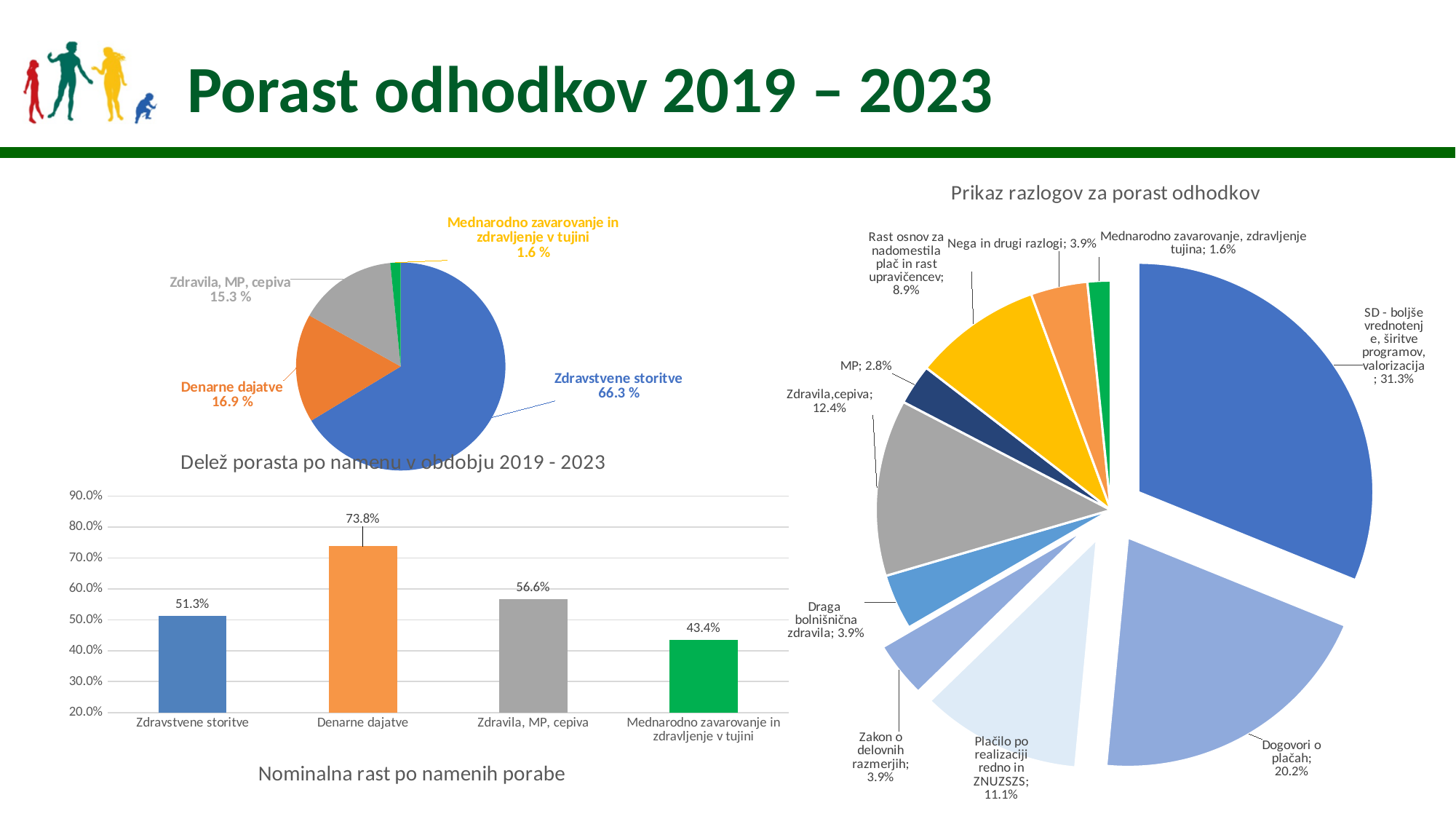
In the 'Nominalna rast po namenih porabe' bar chart, what is the value for Denarne dajatve? 73.8% In the 'Nominalna rast po namenih porabe' bar chart, which category has the lowest value? Mednarodno zavarovanje in zdravljenje v tujini In the 'Prikaz razlogov za porast odhodkov' pie chart, what is the value for 'Zdravila,cepiva'? 12.4% In the 'Prikaz razlogov za porast odhodkov' pie chart, which slice is the largest? SD - boljše vrednotenje, širitve programov, valorizacija In the 'Nominalna rast po namenih porabe' bar chart, which category has the highest value? Denarne dajatve In the 'Delež porasta po namenu v obdobju 2019 - 2023' pie chart, which is larger: Denarne dajatve or Zdravila, MP, cepiva? Denarne dajatve In the 'Prikaz razlogov za porast odhodkov' pie chart, what share does 'Dogovori o plačah' have? 20.2% In the 'Nominalna rast po namenih porabe' bar chart, what is the difference between Denarne dajatve and Zdravstvene storitve? 22.5% In the 'Delež porasta po namenu v obdobju 2019 - 2023' pie chart, what share does Zdravstvene storitve have? 66.3 % In the 'Delež porasta po namenu v obdobju 2019 - 2023' pie chart, which slice is the smallest? Mednarodno zavarovanje in zdravljenje v tujini What kind of chart is 'Nominalna rast po namenih porabe'? Bar chart In the 'Nominalna rast po namenih porabe' bar chart, how many categories are shown? 4